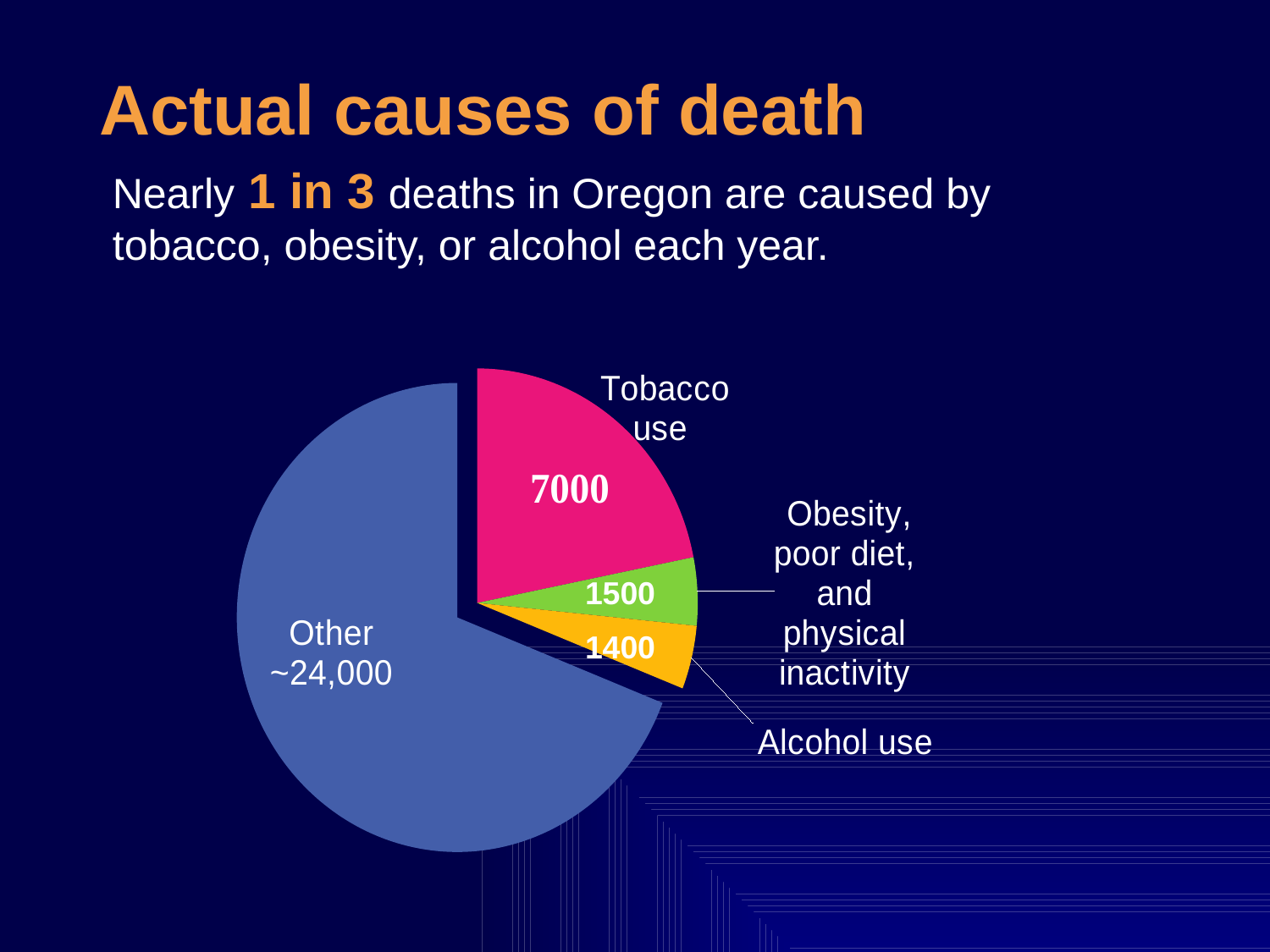
What is the difference between the Tobacco use value and the Alcohol use value? 5600 What kind of chart is shown on the slide? Pie chart Which slice of the pie chart is the largest? Other What value is shown for the Tobacco use slice of the pie chart? 7000 What value is shown for the Alcohol use slice of the pie chart? 1400 What is the difference between the Tobacco use value and the Obesity, poor diet, and physical inactivity value? 5500 What value is shown for the Obesity, poor diet, and physical inactivity slice? 1500 What is the difference between the Obesity, poor diet, and physical inactivity value and the Alcohol use value? 100 How many slices does the pie chart have? 4 Which is larger, the Tobacco use slice or the Alcohol use slice? Tobacco use Which slice of the pie chart has the smallest value? Alcohol use What is the title of the slide containing the chart? Actual causes of death